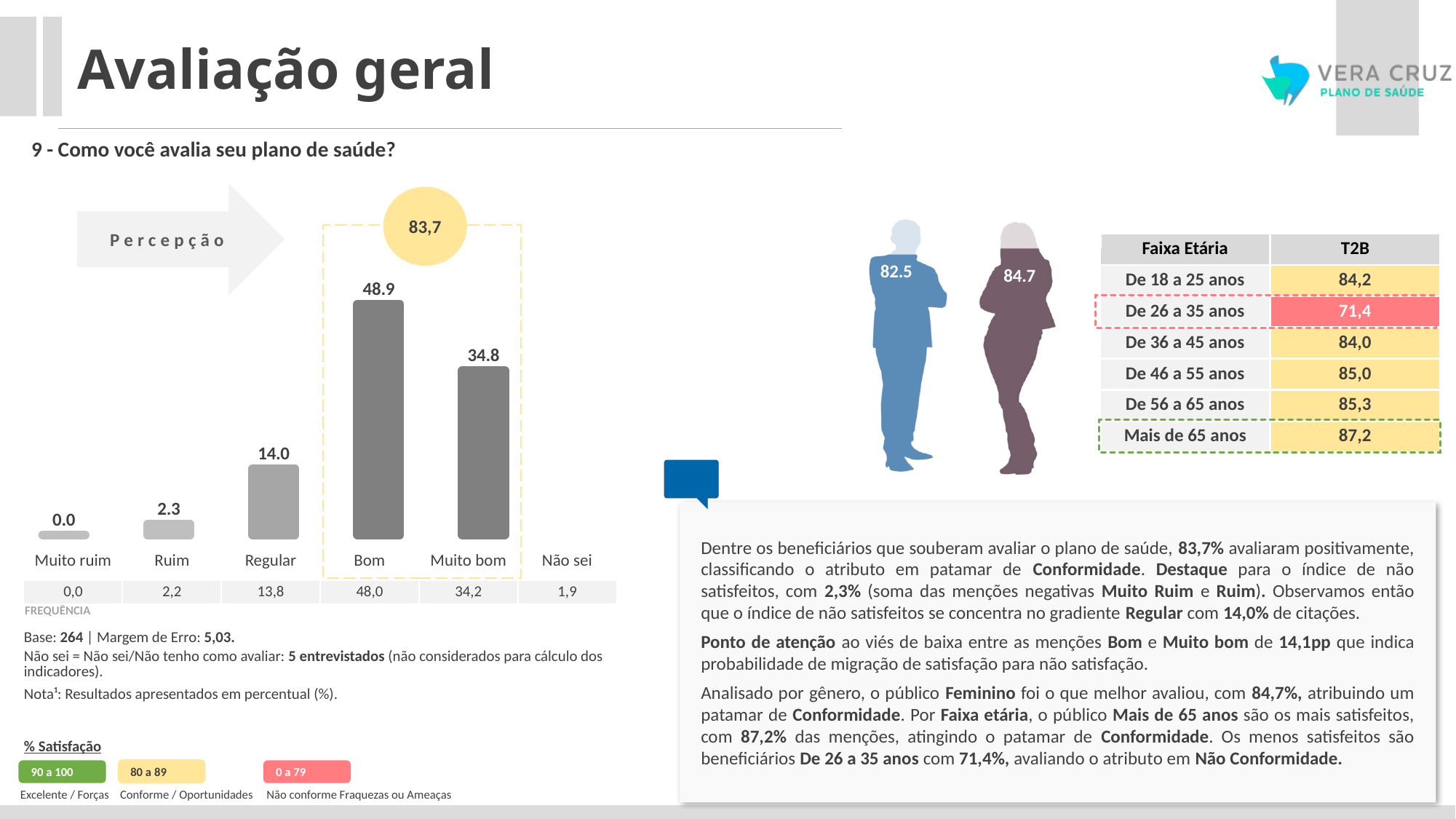
Which category has the lowest value? Muito ruim What is the value shown for Regular? 14.0 What is the value shown for Muito bom? 34.8 What kind of chart is shown on the slide? bar chart What value is shown in the yellow circle above the highlighted Bom and Muito bom bars? 83,7 Which is larger, the value for Regular or the value for Ruim? Regular What is the difference between the values for Bom and Muito bom? 14.1 Which category has the highest value? Bom What is the value shown for Bom? 48.9 What is the value shown for Muito ruim? 0.0 What is the value shown for Ruim? 2.3 Do the values rise or fall along the x axis from Muito ruim to Bom? rise